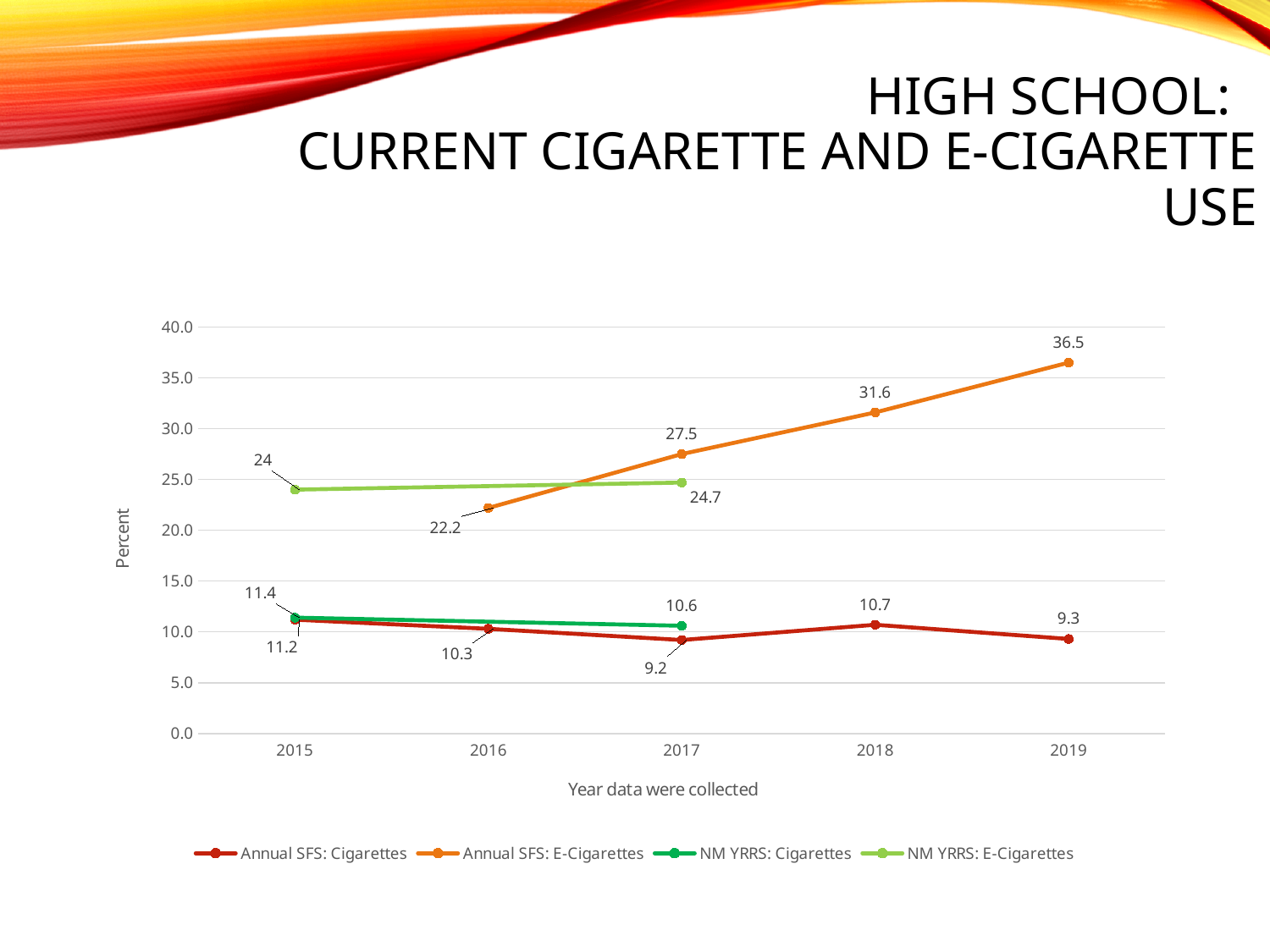
What is the difference between the Annual SFS: E-Cigarettes values for 2019 and 2016? 14.3 Which is larger in 2017: Annual SFS: E-Cigarettes or NM YRRS: E-Cigarettes? Annual SFS: E-Cigarettes How many years are shown on the x axis? 5 What is the value for NM YRRS: E-Cigarettes in 2015? 24 In which year is Annual SFS: Cigarettes lowest? 2017 What is the value for Annual SFS: E-Cigarettes in 2019? 36.5 What type of chart is shown on the slide? line chart How many series does the legend list? 4 What is the value for Annual SFS: Cigarettes in 2017? 9.2 What is the value for NM YRRS: Cigarettes in 2017? 10.6 Does the Annual SFS: E-Cigarettes series rise or fall from 2016 to 2019? rise In which year is Annual SFS: E-Cigarettes highest? 2019